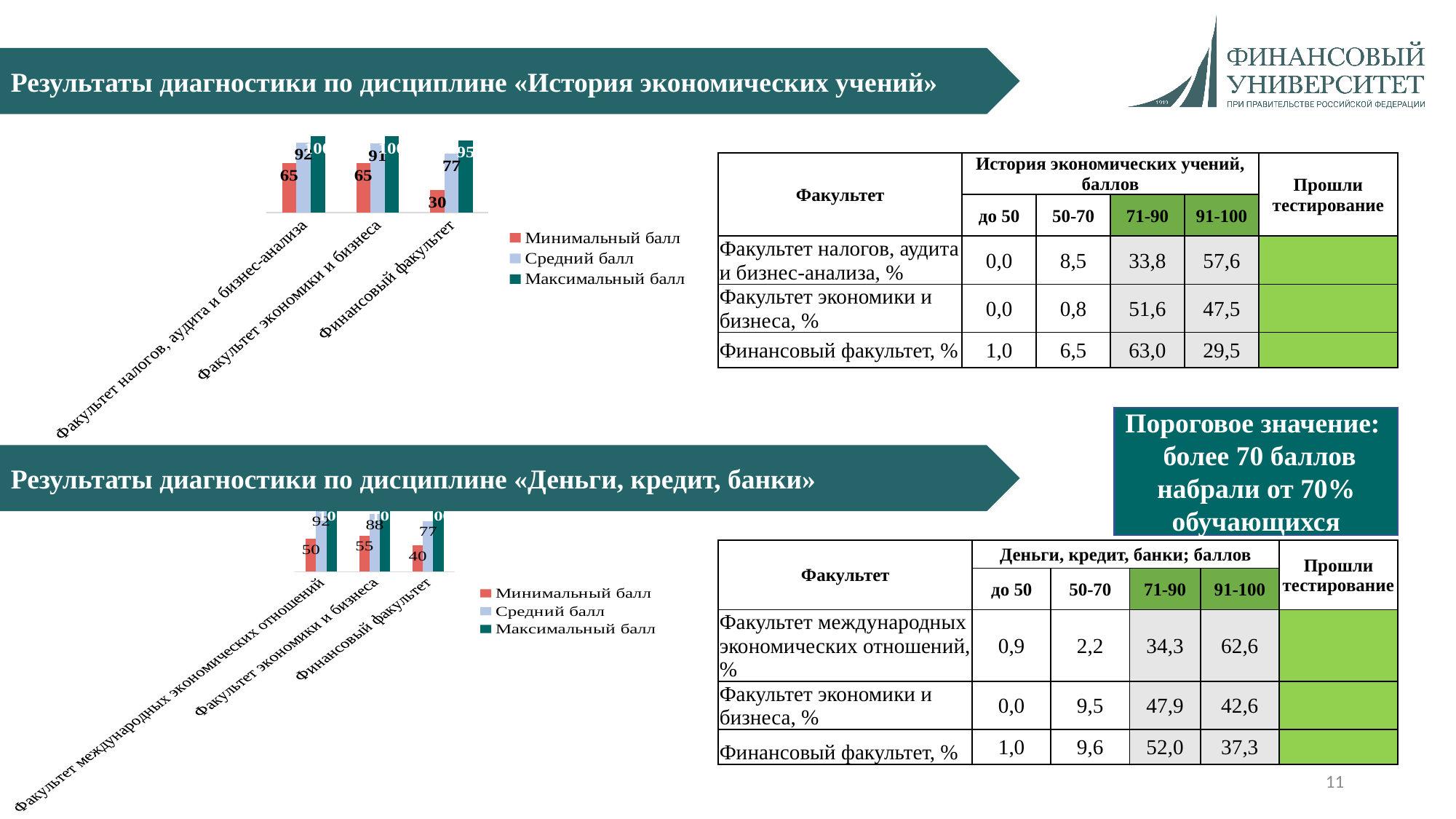
In the bottom chart (Деньги, кредит, банки), what is the difference between the minimum scores of Факультет экономики и бизнеса and Финансовый факультет? 15 In the bottom chart (Деньги, кредит, банки), which faculty has the highest average score? Факультет международных экономических отношений In the bottom chart (Деньги, кредит, банки), which is larger: the minimum score for Факультет международных экономических отношений or for Финансовый факультет? Факультет международных экономических отношений In the top chart (История экономических учений), what is the difference between the average score and the minimum score for Финансовый факультет? 47 What type of chart is the bottom chart (Деньги, кредит, банки)? Bar chart In the bottom chart (Деньги, кредит, банки), what is the minimum score (Минимальный балл) for Факультет экономики и бизнеса? 55 In the top chart (История экономических учений), what is the minimum score (Минимальный балл) for Финансовый факультет? 30 In the top chart (История экономических учений), what is the average score (Средний балл) for Факультет налогов, аудита и бизнес-анализа? 92 How many series does the legend of the top chart (История экономических учений) list? 3 In the top chart (История экономических учений), which faculty has the lowest minimum score? Финансовый факультет In the bottom chart (Деньги, кредит, банки), what is the average score (Средний балл) for Факультет международных экономических отношений? 92 In the top chart (История экономических учений), what is the average score (Средний балл) for Факультет экономики и бизнеса? 91